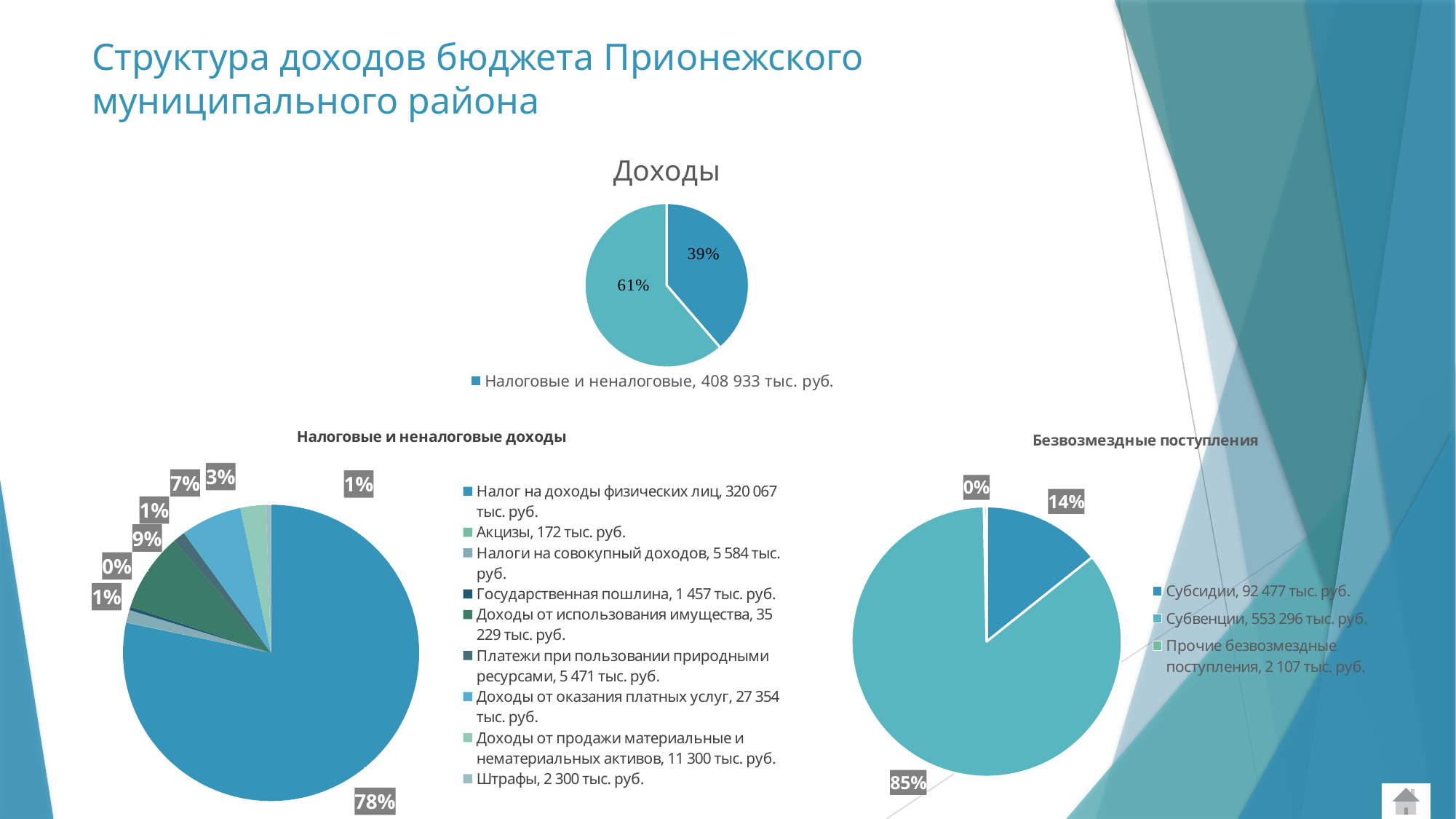
In the "Налоговые и неналоговые доходы" chart, how many categories does the legend list? 9 What kind of chart is the "Доходы" chart at the top of the slide? pie chart In the "Налоговые и неналоговые доходы" chart, which category has the largest slice? Налог на доходы физических лиц In the "Безвозмездные поступления" chart, what value does the legend give for "Субсидии"? 92 477 тыс. руб. In the "Безвозмездные поступления" chart, what share does "Субвенции" have? 85% In the "Доходы" chart, what value does the legend give for "Налоговые и неналоговые"? 408 933 тыс. руб. In the "Налоговые и неналоговые доходы" chart, what value does the legend give for "Налог на доходы физических лиц"? 320 067 тыс. руб. In the "Налоговые и неналоговые доходы" chart, what value does the legend give for "Доходы от использования имущества"? 35 229 тыс. руб. In the "Доходы" pie chart, what share does "Налоговые и неналоговые" have? 39% In the "Налоговые и неналоговые доходы" chart, what share does "Налог на доходы физических лиц" have? 78% In the "Безвозмездные поступления" chart, which category has the smallest slice? Прочие безвозмездные поступления In the "Безвозмездные поступления" chart, what is the difference between "Субвенции" and "Субсидии"? 460 819 тыс. руб.